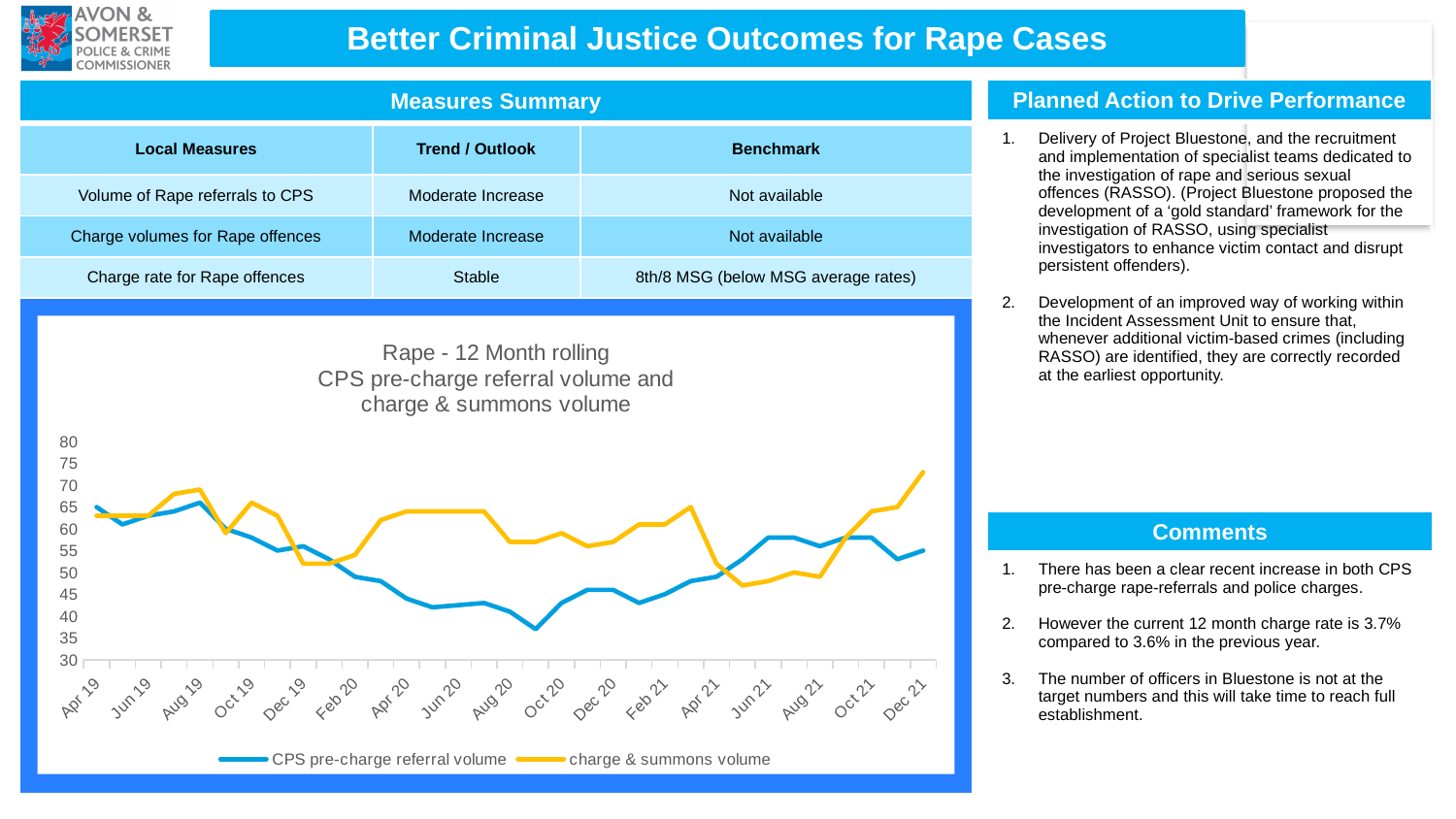
Is the CPS pre-charge referral volume for Oct 20 greater or less than 40? greater What is the title of the chart? Rape - 12 Month rolling CPS pre-charge referral volume and charge & summons volume Is the charge & summons volume for Apr 20 greater or less than 60? greater What are the two series named in the chart legend? CPS pre-charge referral volume; charge & summons volume Is the charge & summons volume for Dec 21 greater or less than 70? greater Does the CPS pre-charge referral volume generally rise or fall between Apr 19 and Oct 20? fall What kind of chart is shown on the slide? Line chart How many series does the chart legend list? 2 At Dec 21, which series has the higher value: CPS pre-charge referral volume or charge & summons volume? charge & summons volume At which month does the CPS pre-charge referral volume reach its lowest point? Sep 20 At Jun 21, which series has the higher value: CPS pre-charge referral volume or charge & summons volume? CPS pre-charge referral volume